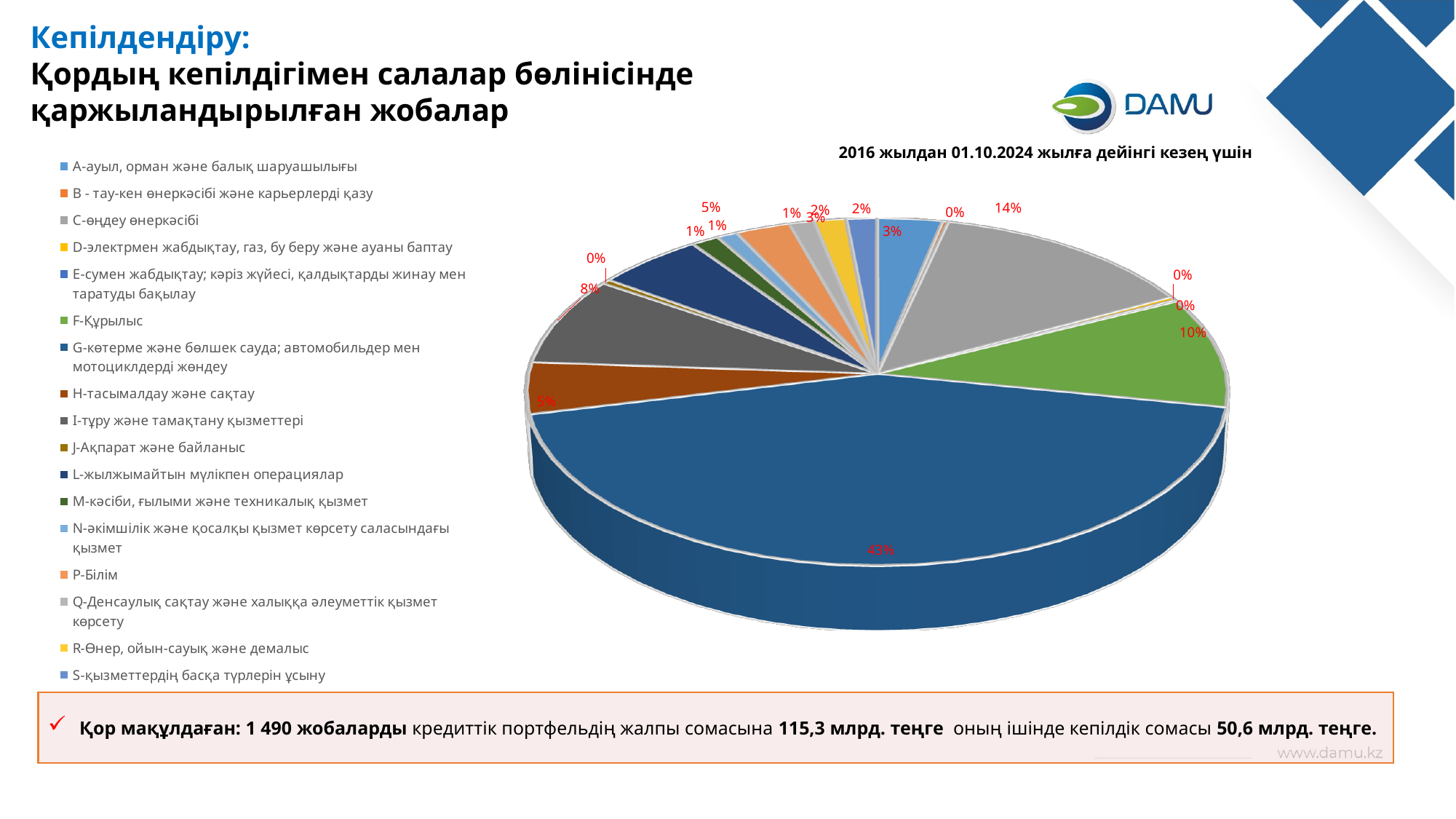
What is the difference in percentage points between the share of G-көтерме және бөлшек сауда (43%) and C-өңдеу өнеркәсібі (14%)? 29 percentage points What share of the pie does the largest slice (G-көтерме және бөлшек сауда) have? 43% What period does the chart's title say the data covers? 2016 жылдан 01.10.2024 жылға дейінгі кезең үшін Which category has the largest share of the pie? G-көтерме және бөлшек сауда; автомобильдер мен мотоциклдерді жөндеу What share of the pie does F-Құрылыс have? 10% What share of the pie does I-тұру және тамақтану қызметтері have? 8% What kind of chart is shown on the slide? pie chart How many categories does the legend of the pie chart list? 17 Which is larger: the share of C-өңдеу өнеркәсібі or the share of F-Құрылыс? C-өңдеу өнеркәсібі